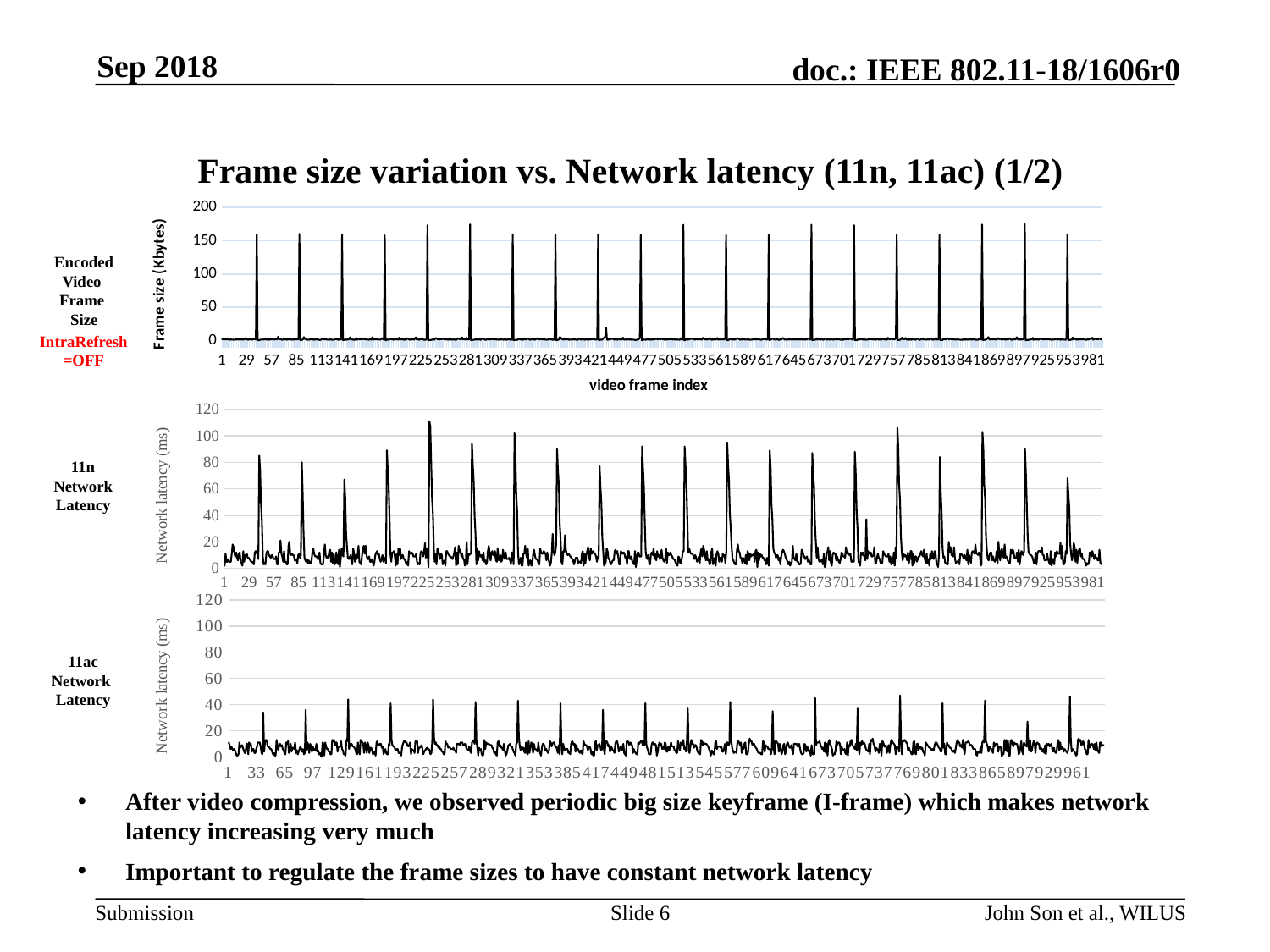
What kind of chart is the Encoded Video Frame Size chart at the top of the slide? line chart What is the x-axis label of the top chart (Encoded Video Frame Size)? video frame index Which chart shows higher peak network latency, the 11n Network Latency chart or the 11ac Network Latency chart? 11n Network Latency In the top chart (Encoded Video Frame Size), is the frame size between the peaks greater or less than 50? less In the 11ac Network Latency chart, is the baseline latency between the peaks greater or less than 20? less In the 11ac Network Latency chart, is the highest latency peak greater or less than 60? less In the 11n Network Latency chart, what is the maximum value shown on the y-axis? 120 In the top chart (Encoded Video Frame Size), what is the maximum value shown on the y-axis? 200 In the top chart (Encoded Video Frame Size), do the values rise steadily, fall steadily, or show periodic spikes along the x axis? periodic spikes What is the y-axis label of the top chart (Encoded Video Frame Size)? Frame size (Kbytes)